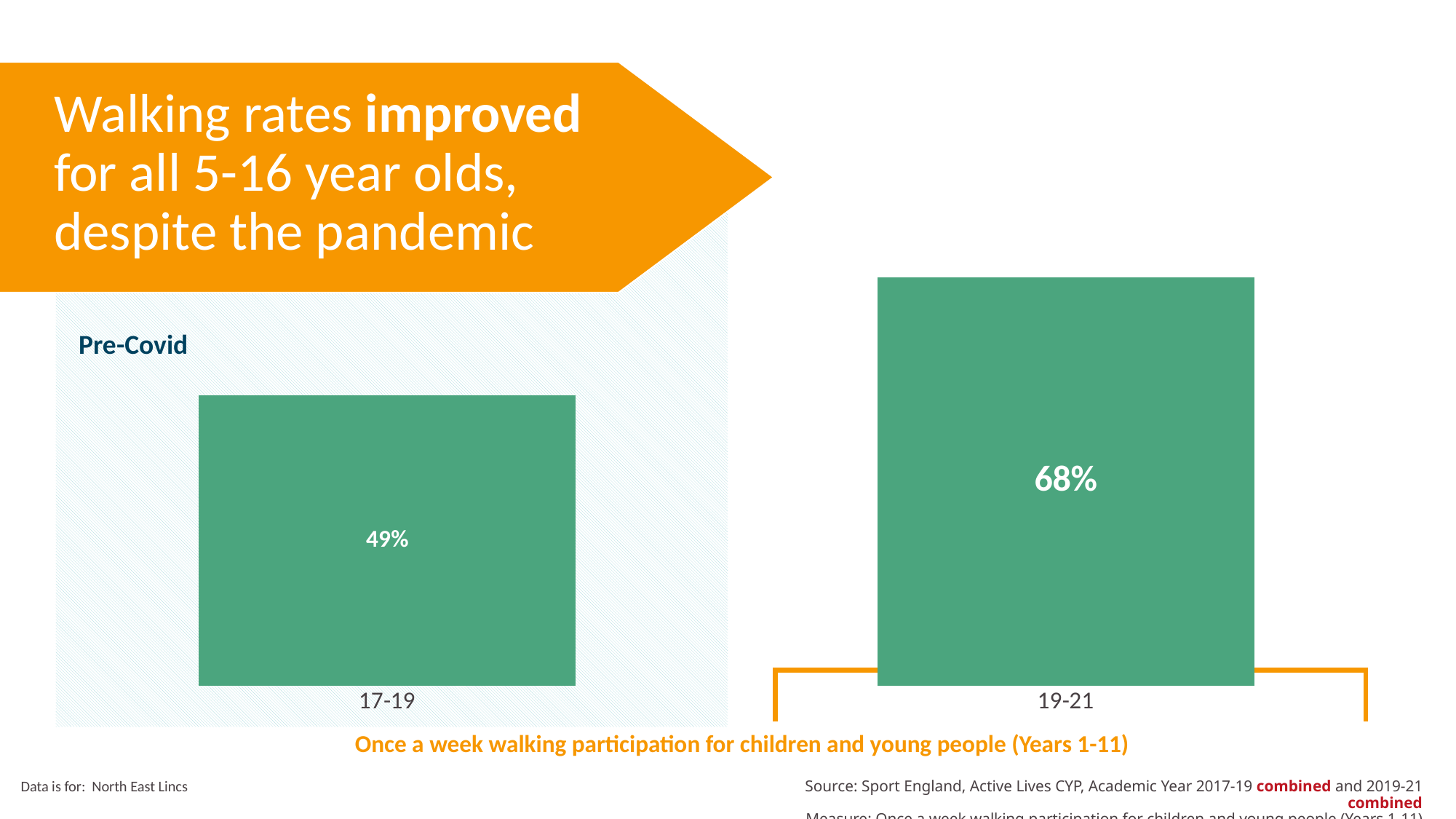
Which period is labelled as Pre-Covid on the chart? 17-19 Which period has the highest walking participation rate? 19-21 What is the once-a-week walking participation rate for 19-21? 68% How many periods (bars) are shown in the chart? 2 Which period has the higher walking participation rate, 17-19 or 19-21? 19-21 What is the once-a-week walking participation rate for 17-19? 49% By how many percentage points did the walking participation rate change from 17-19 to 19-21? 19 percentage points What is the caption below the chart describing the measure? Once a week walking participation for children and young people (Years 1-11) What kind of chart is shown on the slide? Bar chart Which period has the lowest walking participation rate? 17-19 Do walking participation rates rise or fall from 17-19 to 19-21? Rise